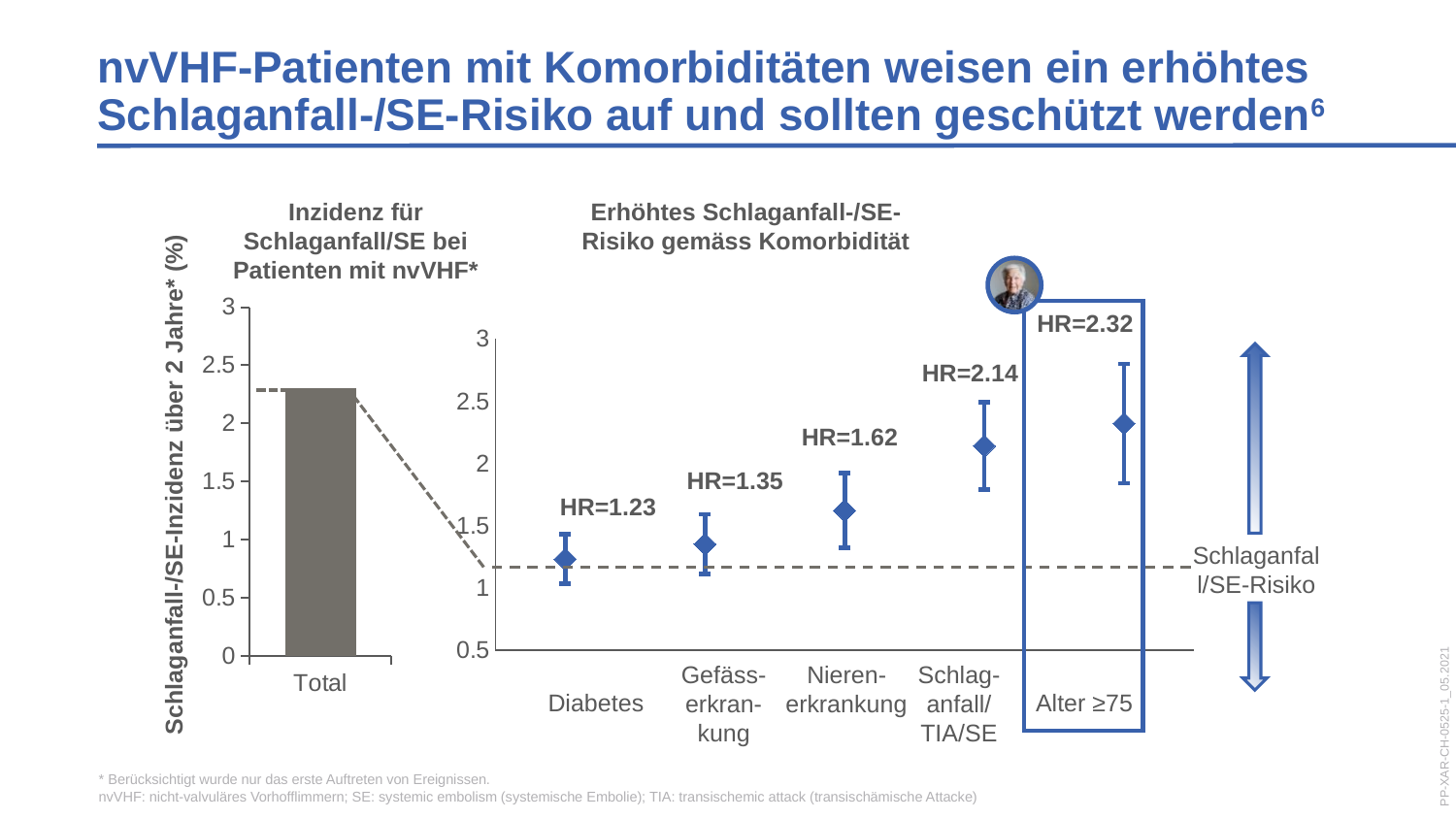
In the chart 'Erhöhtes Schlaganfall-/SE-Risiko gemäss Komorbidität', do the HR values rise or fall from left to right along the x axis? rise In the chart 'Inzidenz für Schlaganfall/SE bei Patienten mit nvVHF*', is the value for Total greater or less than 2? greater In the chart 'Erhöhtes Schlaganfall-/SE-Risiko gemäss Komorbidität', which comorbidity has the lowest HR? Diabetes In the chart 'Erhöhtes Schlaganfall-/SE-Risiko gemäss Komorbidität', which comorbidity has the highest HR? Alter ≥75 In the chart 'Erhöhtes Schlaganfall-/SE-Risiko gemäss Komorbidität', what is the difference between the HR for Alter ≥75 and the HR for Diabetes? 1.09 What kind of chart is the left chart 'Inzidenz für Schlaganfall/SE bei Patienten mit nvVHF*'? bar chart In the chart 'Erhöhtes Schlaganfall-/SE-Risiko gemäss Komorbidität', which has a higher HR: Gefässerkrankung or Schlaganfall/TIA/SE? Schlaganfall/TIA/SE In the chart 'Erhöhtes Schlaganfall-/SE-Risiko gemäss Komorbidität', what is the HR value for Nierenerkrankung? HR=1.62 In the chart 'Erhöhtes Schlaganfall-/SE-Risiko gemäss Komorbidität', what is the HR value for Diabetes? HR=1.23 In the chart 'Inzidenz für Schlaganfall/SE bei Patienten mit nvVHF*', is the value for Total greater or less than 2.5? less In the chart 'Erhöhtes Schlaganfall-/SE-Risiko gemäss Komorbidität', what is the HR value for Alter ≥75? HR=2.32 In the chart 'Erhöhtes Schlaganfall-/SE-Risiko gemäss Komorbidität', how many comorbidity categories are shown on the x axis? 5